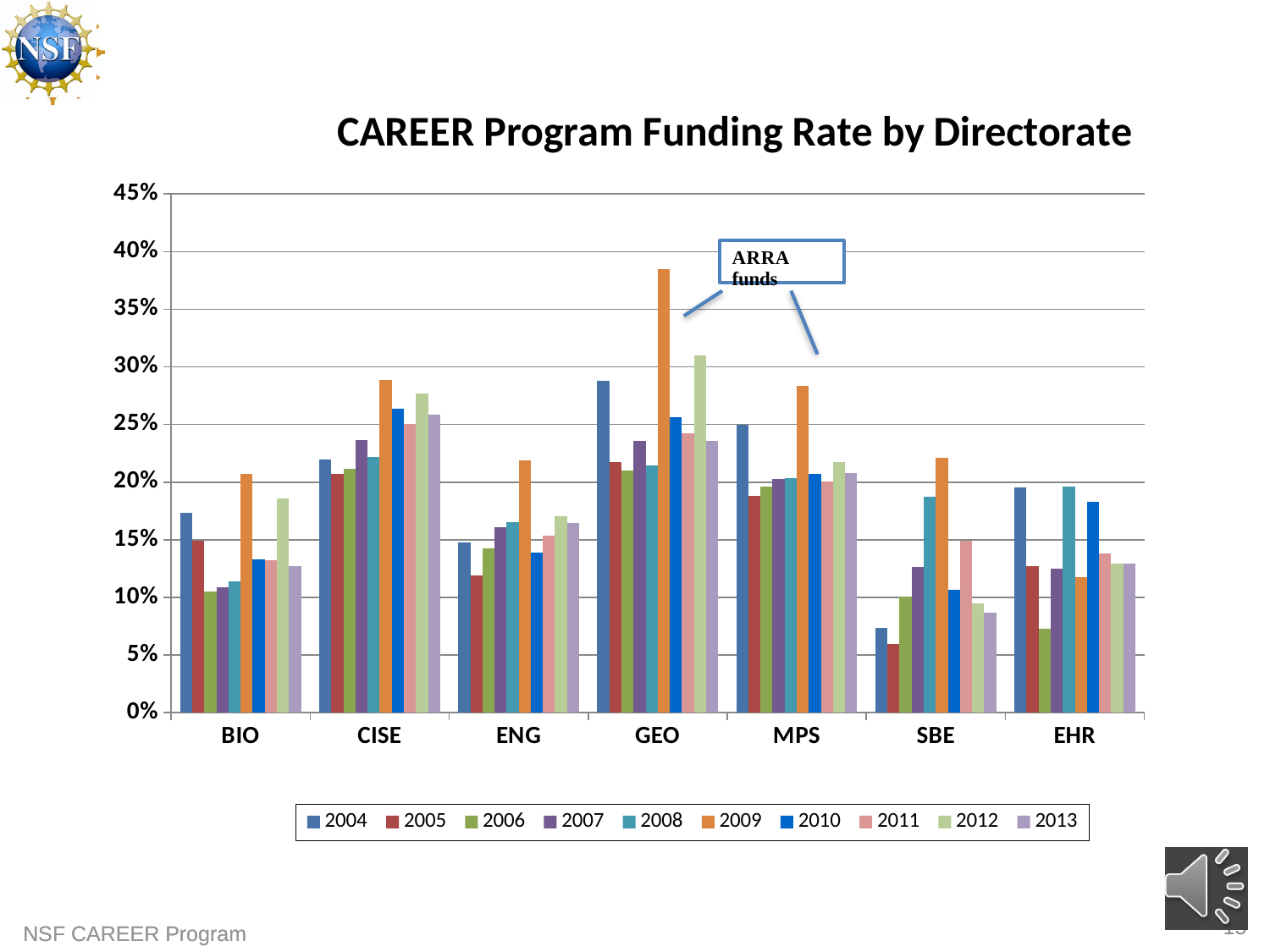
What is the title of the chart? CAREER Program Funding Rate by Directorate How many years (series) does the legend list? 10 What kind of chart is shown on the slide? Bar chart Which directorate has the lowest funding rate for 2009? EHR For BIO, which year has the higher funding rate, 2004 or 2006? 2004 Is the 2005 funding rate for SBE greater or less than 10%? less Within the GEO directorate, which year has the highest funding rate? 2009 Is the 2009 funding rate for CISE greater or less than 25%? greater How many directorates are shown along the x axis of the chart? 7 Is the 2009 funding rate for GEO greater or less than 35%? greater Which directorate has the highest funding rate for 2009? GEO For MPS, which year has the higher funding rate, 2004 or 2005? 2004